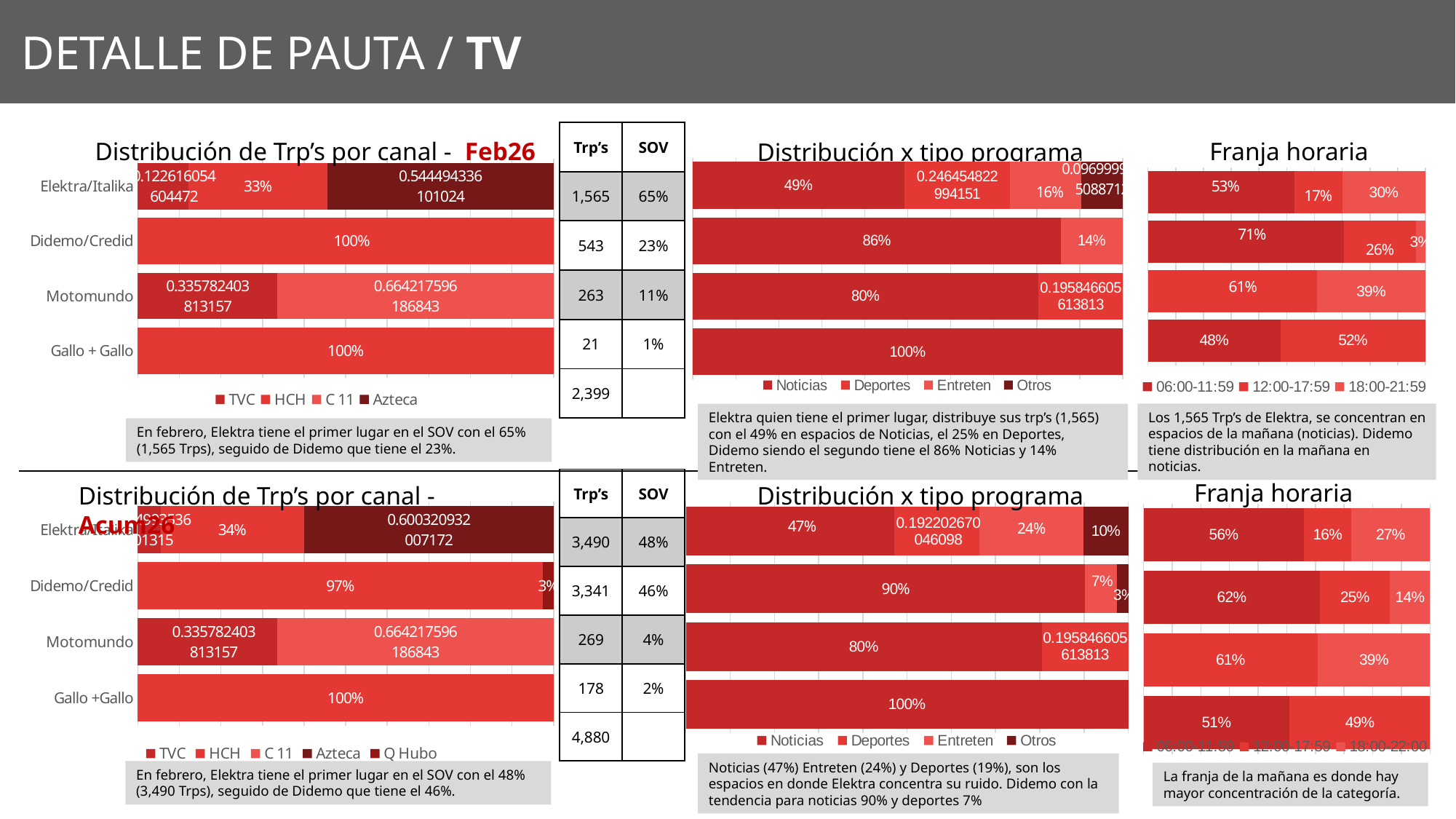
In the top 'Distribución x tipo programa' chart (Feb26), which is larger: the Noticias share for Didemo/Credid or the Noticias share for Motomundo? Didemo/Credid How many categories are shown in the top 'Distribución x tipo programa' chart (Feb26)? 4 How many series does the legend of the bottom 'Distribución de Trp's por canal - Acum26' chart list? 5 In the bottom 'Distribución x tipo programa' chart (Acum26), what is the Otros share for Elektra/Italika? 10% In the top 'Distribución x tipo programa' chart (Feb26), what is the Noticias share for Elektra/Italika? 49% What kind of chart is the top 'Franja horaria' chart (Feb26)? Stacked bar chart In the top 'Franja horaria' chart (Feb26), what is the 06:00-11:59 share for Didemo/Credid? 71% In the bottom 'Franja horaria' chart (Acum26), what is the 12:00-17:59 share for Didemo/Credid? 25% In the top 'Distribución de Trp's por canal - Feb26' chart, what is the HCH share for Elektra/Italika? 33% In the bottom 'Franja horaria' chart (Acum26), what is the difference between the 06:00-11:59 share of Didemo/Credid and that of Elektra/Italika? 6% In the top 'Franja horaria' chart (Feb26), which category has the highest 06:00-11:59 share? Didemo/Credid